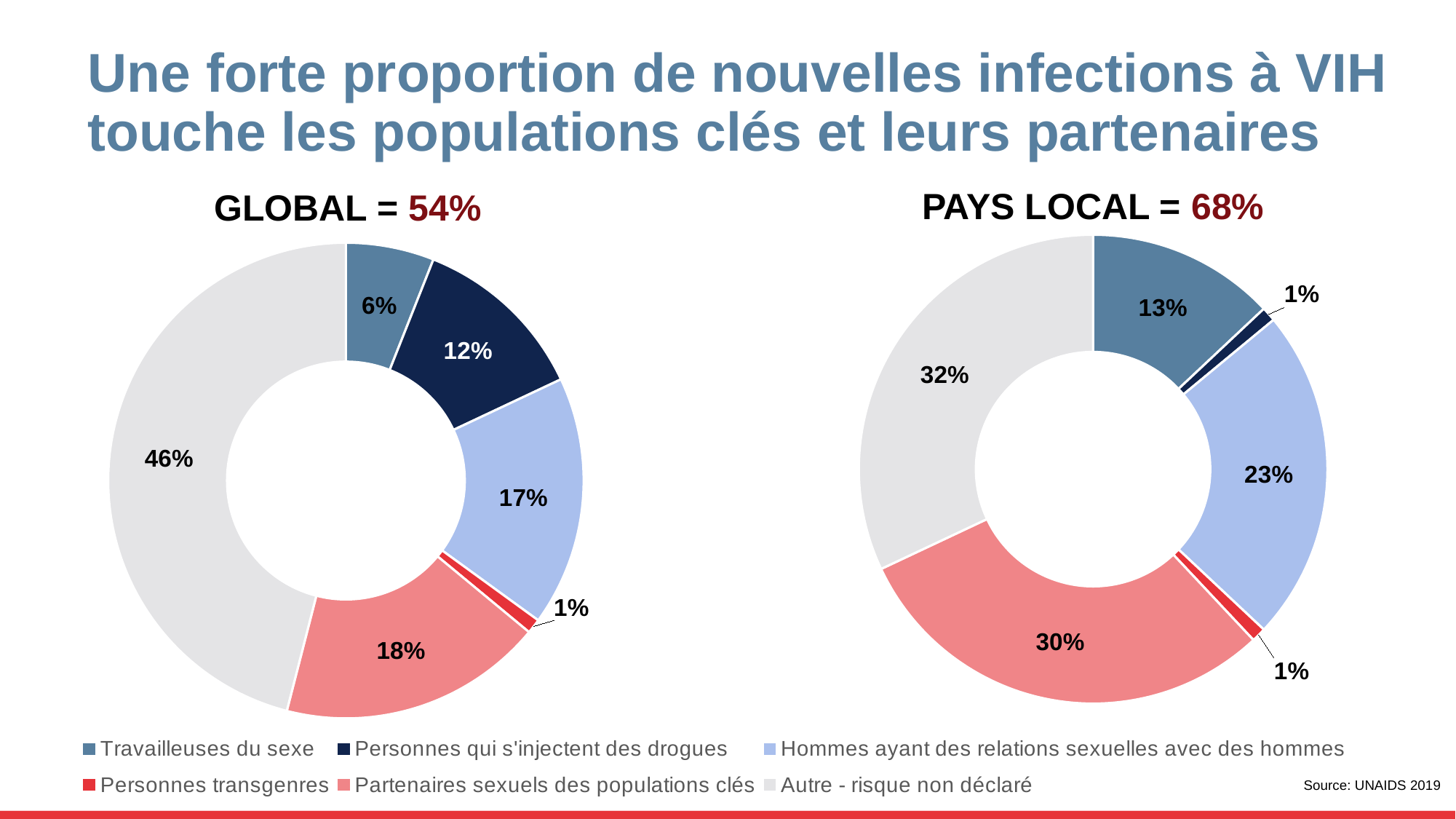
What percentage is shown in the title of the PAYS LOCAL chart? 68% In the GLOBAL chart, what share is labelled for Autre - risque non déclaré? 46% In the PAYS LOCAL chart, what share is labelled for Partenaires sexuels des populations clés? 30% In the GLOBAL chart, which category has the smallest share? Personnes transgenres In the GLOBAL chart, which is larger: the share for Partenaires sexuels des populations clés or the share for Hommes ayant des relations sexuelles avec des hommes? Partenaires sexuels des populations clés What kind of chart is the GLOBAL chart? Donut (pie) chart What is the combined share of Travailleuses du sexe and Personnes qui s'injectent des drogues in the GLOBAL chart? 18% What is the difference between the Travailleuses du sexe share in the PAYS LOCAL chart and in the GLOBAL chart? 7% In the GLOBAL chart, what share is labelled for Personnes qui s'injectent des drogues? 12% How many categories does the legend list for the charts? 6 In the PAYS LOCAL chart, which category has the largest share? Autre - risque non déclaré In the PAYS LOCAL chart, what share is labelled for Hommes ayant des relations sexuelles avec des hommes? 23%